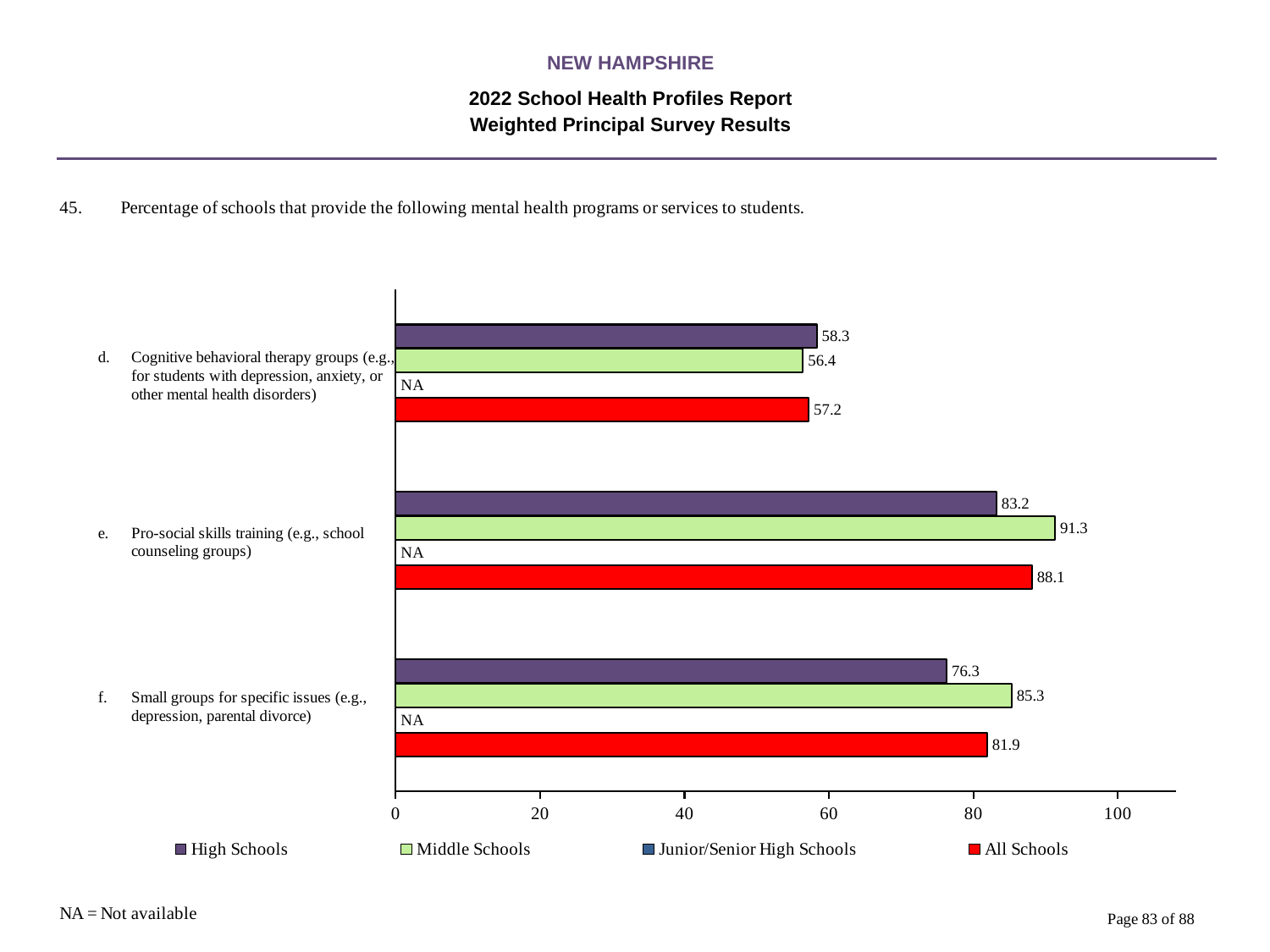
Which category has the lowest High Schools value? Cognitive behavioral therapy groups (e.g., for students with depression, anxiety, or other mental health disorders) For Small groups for specific issues, which is larger: the High Schools value or the All Schools value? All Schools What value is shown for Junior/Senior High Schools in each category? NA How many categories are shown on the chart? 3 What is the value for Middle Schools for Small groups for specific issues (e.g., depression, parental divorce)? 85.3 What is the value for All Schools for Cognitive behavioral therapy groups? 57.2 Is the All Schools value for Pro-social skills training greater or less than 80? greater What kind of chart is shown on the slide? bar chart What is the difference between the Middle Schools and High Schools values for Pro-social skills training? 8.1 What is the value for High Schools for Pro-social skills training (e.g., school counseling groups)? 83.2 How many series does the legend list? 4 Which category has the highest Middle Schools value? Pro-social skills training (e.g., school counseling groups)